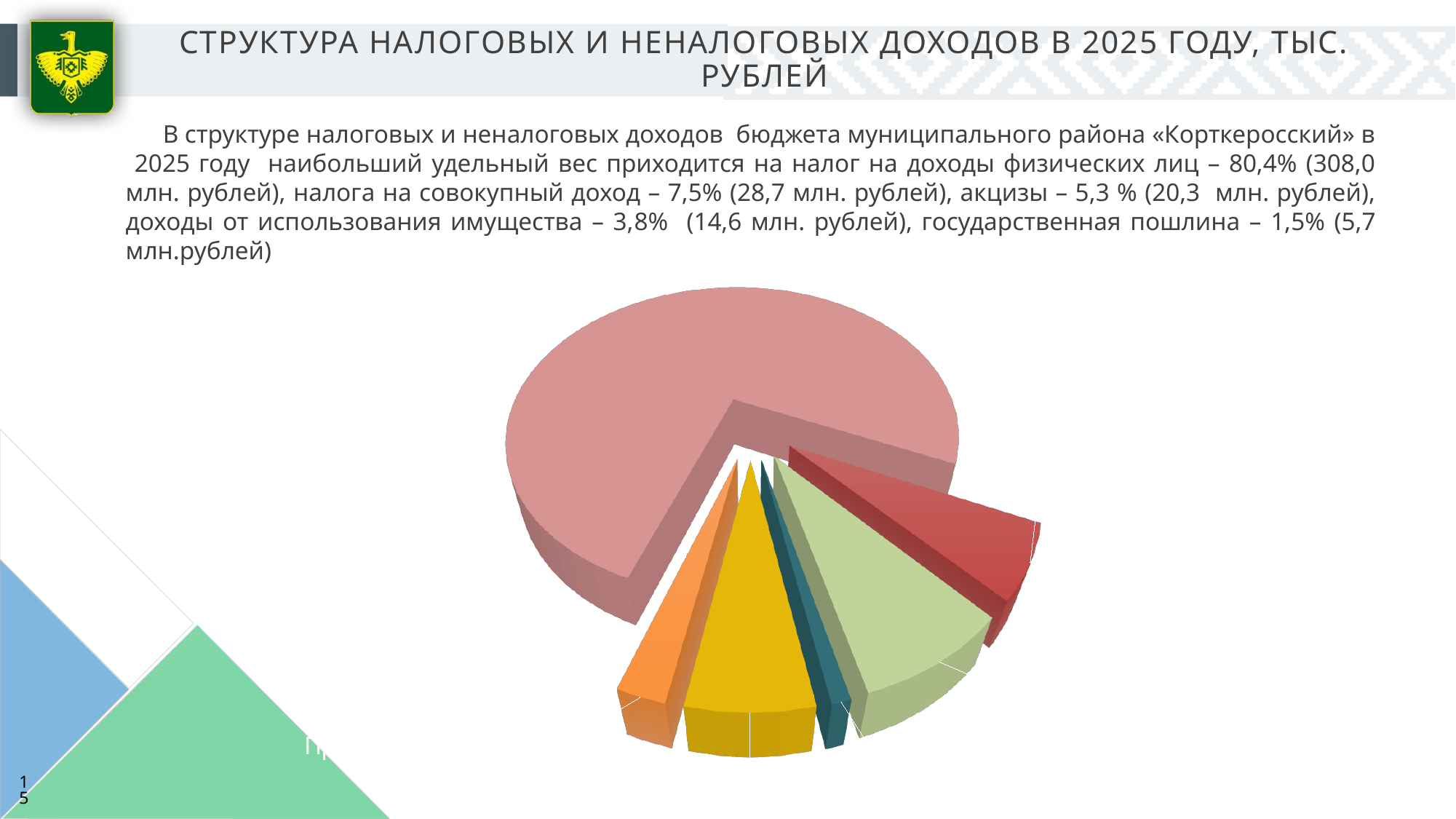
What is the title of the slide containing the pie chart? СТРУКТУРА НАЛОГОВЫХ И НЕНАЛОГОВЫХ ДОХОДОВ В 2025 ГОДУ, ТЫС. РУБЛЕЙ Does the pie chart have a legend? No Which colour slice is the smallest in the pie chart? teal What kind of chart is shown on the slide? pie chart Which slice is larger in the pie chart, the yellow one or the teal one? yellow How many slices does the pie chart have? 6 Which slice is larger in the pie chart, the pink one or the red one? pink Which colour slice is the largest in the pie chart? pink